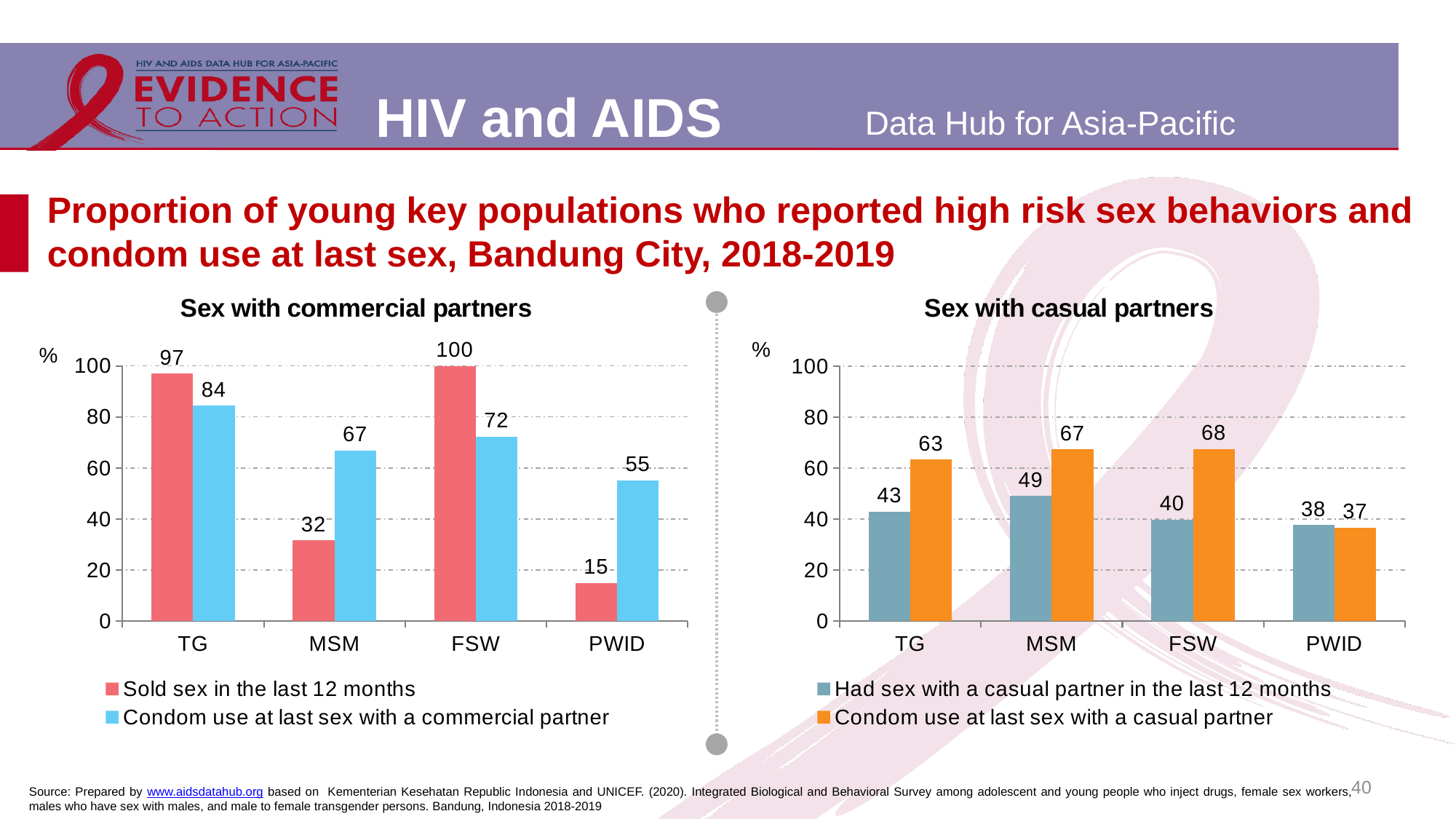
In the 'Sex with casual partners' chart, what is the difference between 'Condom use at last sex with a casual partner' and 'Had sex with a casual partner in the last 12 months' for TG? 20 How many series does the legend of the 'Sex with casual partners' chart list? 2 What kind of chart is the 'Sex with casual partners' chart? Bar chart In the 'Sex with casual partners' chart, what is the value for 'Condom use at last sex with a casual partner' for FSW? 68 In the 'Sex with commercial partners' chart, what is the value for 'Condom use at last sex with a commercial partner' for PWID? 55 In the 'Sex with commercial partners' chart, what is the difference between 'Sold sex in the last 12 months' and 'Condom use at last sex with a commercial partner' for MSM? 35 In the 'Sex with commercial partners' chart, which category has the lowest value for 'Sold sex in the last 12 months'? PWID In the 'Sex with commercial partners' chart, what is the value for 'Sold sex in the last 12 months' for TG? 97 In the 'Sex with commercial partners' chart, which category has the highest value for 'Sold sex in the last 12 months'? FSW In the 'Sex with casual partners' chart, which is larger for MSM: 'Had sex with a casual partner in the last 12 months' or 'Condom use at last sex with a casual partner'? Condom use at last sex with a casual partner How many categories are shown on the x axis of the 'Sex with commercial partners' chart? 4 In the 'Sex with casual partners' chart, which category has the highest value for 'Had sex with a casual partner in the last 12 months'? MSM